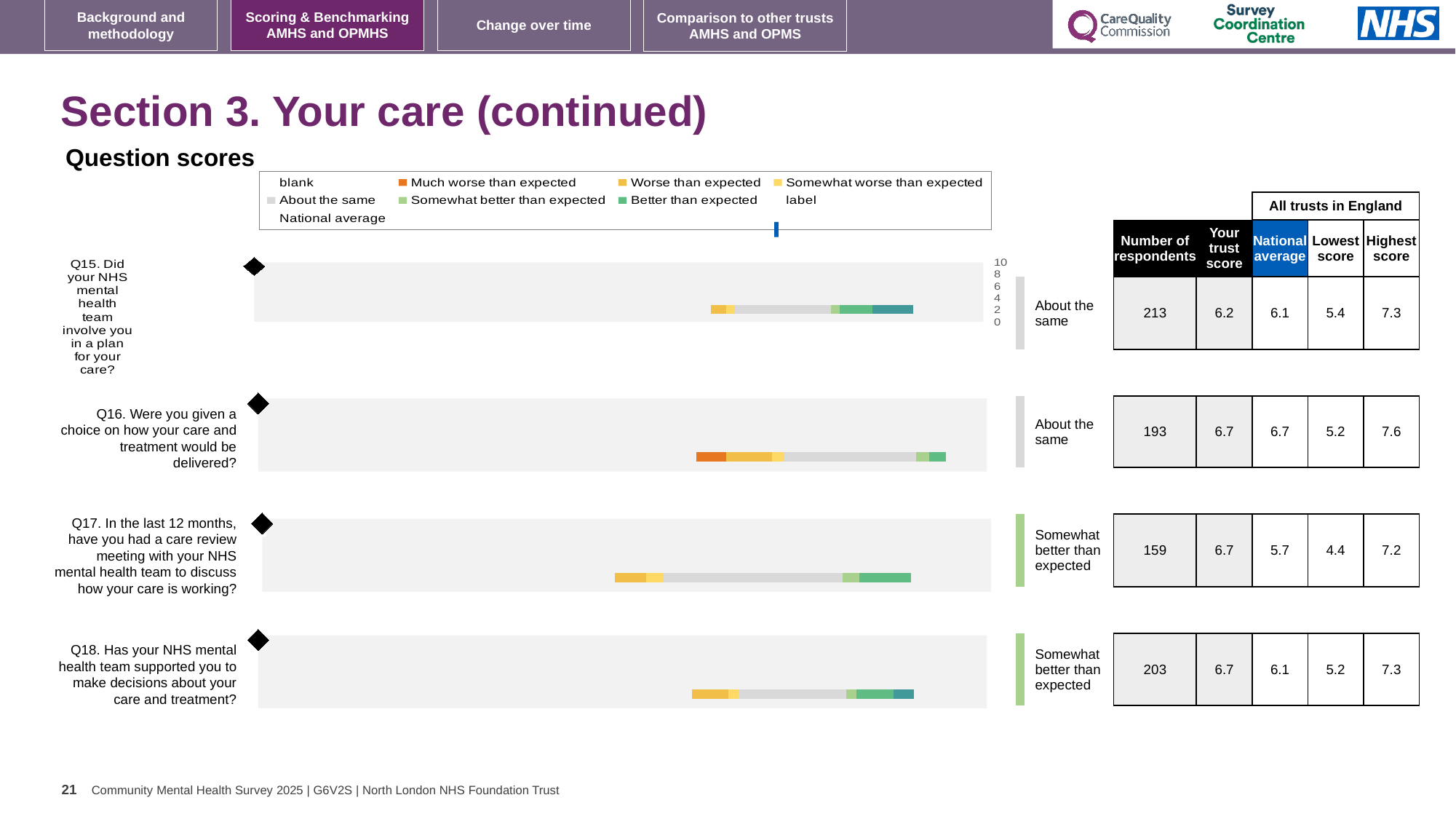
In the table beside the charts, what is the trust score for Q16? 6.7 What kind of chart is used to show the question scores for Q15 to Q18? Bar chart In the legend, what colour represents 'Much worse than expected'? Orange Which question has the highest number of respondents in the table? Q15 In the table beside the charts, what is the lowest score for Q18? 5.2 In the table beside the charts, what is the national average for Q17? 5.7 What benchmark label is shown next to the bar for Q17? Somewhat better than expected How many survey questions (Q15 to Q18) have a bar plotted on the slide? 4 For Q15, which is larger in the table: the trust score or the national average? Trust score For Q17, what is the difference between the trust score and the national average in the table? 1.0 Which question has the lowest number of respondents in the table? Q17 In the table beside the charts, what is the number of respondents for Q15? 213